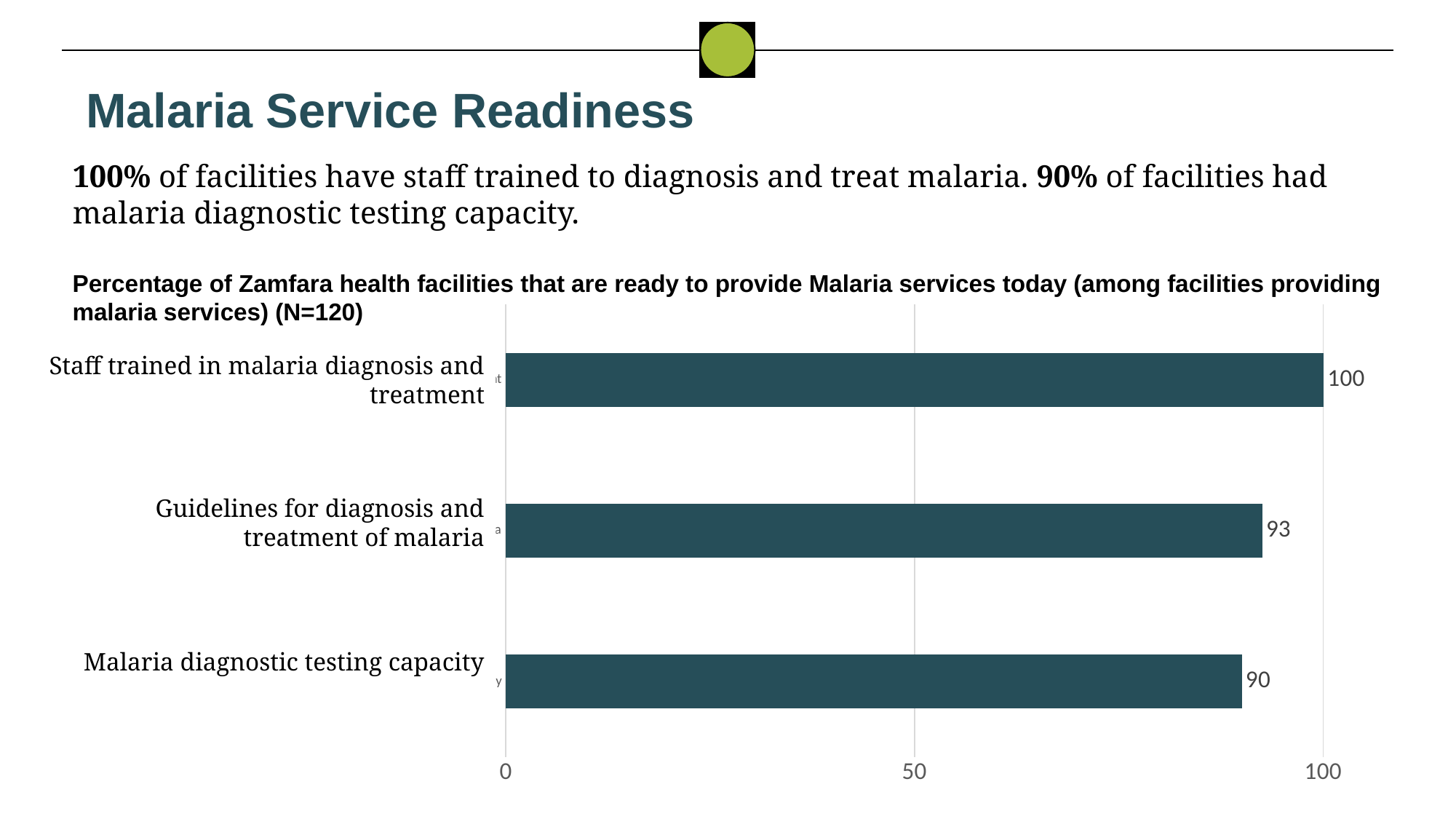
Is the value for Malaria diagnostic testing capacity greater or less than 50? greater How many categories are shown in the chart? 3 Which category has the highest value? Staff trained in malaria diagnosis and treatment What kind of chart is shown on the slide? bar chart What is the difference between the values for Guidelines for diagnosis and treatment of malaria and Malaria diagnostic testing capacity? 3 Which category has the lowest value? Malaria diagnostic testing capacity What is the value for Guidelines for diagnosis and treatment of malaria? 93 What is the value for Staff trained in malaria diagnosis and treatment? 100 What is the value for Malaria diagnostic testing capacity? 90 What is the difference between the values for Staff trained in malaria diagnosis and treatment and Malaria diagnostic testing capacity? 10 Which is larger: the value for Guidelines for diagnosis and treatment of malaria or the value for Malaria diagnostic testing capacity? Guidelines for diagnosis and treatment of malaria What is the sample size (N) stated in the chart title? 120